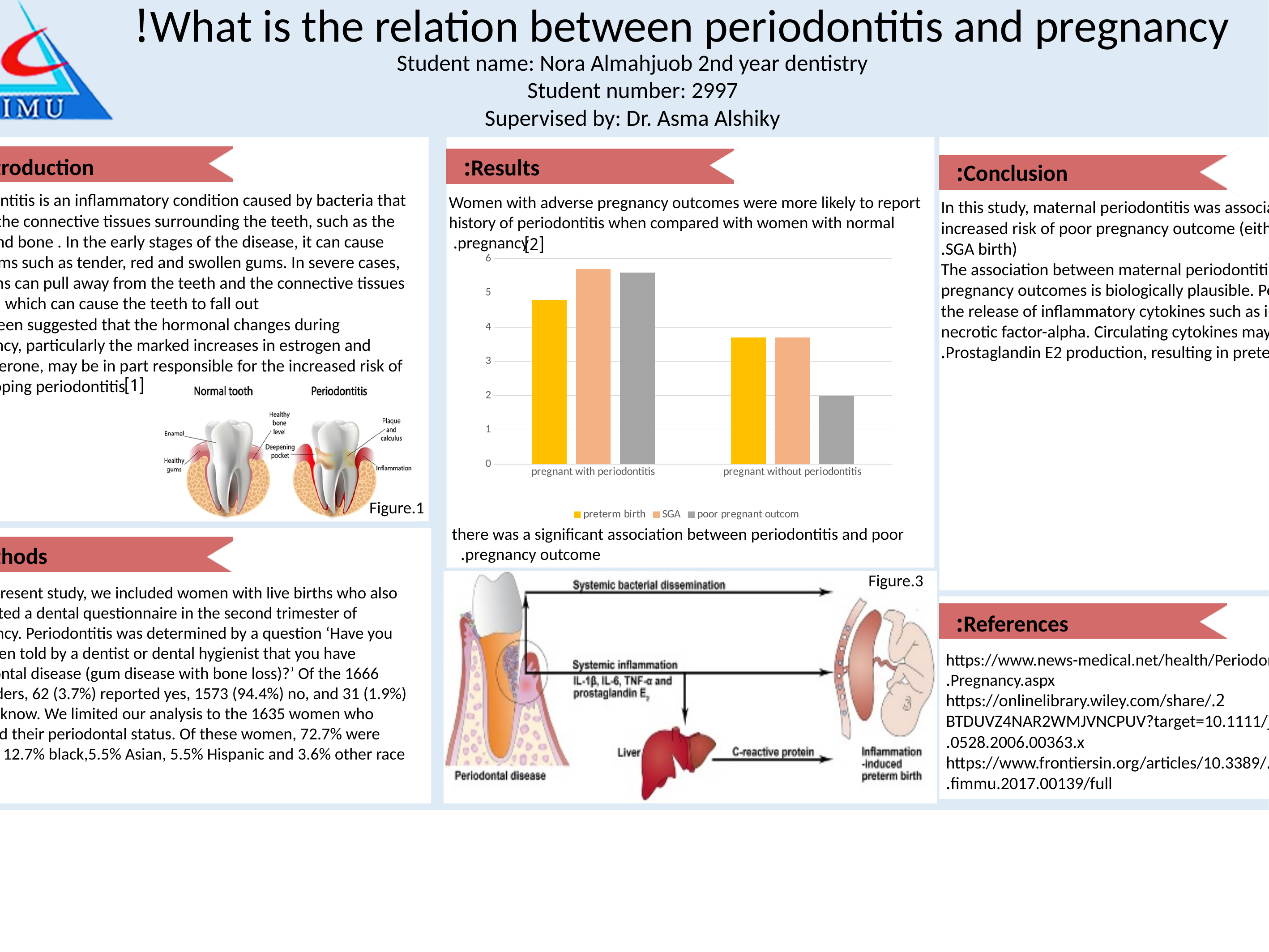
In the Results chart, which series has the lowest value for pregnant without periodontitis? poor pregnant outcom In the Results chart, which series has the lowest value for pregnant with periodontitis? preterm birth What kind of chart is shown in the Results section? bar chart In the Results chart, is the preterm birth value for pregnant without periodontitis greater or less than 3? greater In the Results chart, is the poor pregnant outcome value larger for pregnant with periodontitis or pregnant without periodontitis? pregnant with periodontitis In the Results chart, is the SGA value larger for pregnant with periodontitis or pregnant without periodontitis? pregnant with periodontitis How many categories are shown on the x axis of the Results chart? 2 In the Results chart, is the SGA value for pregnant with periodontitis greater or less than 5? greater How many series does the legend of the Results chart list? 3 In the Results chart, is the poor pregnant outcome value for pregnant without periodontitis greater or less than 3? less In the Results chart, which series is shown in gray? poor pregnant outcom